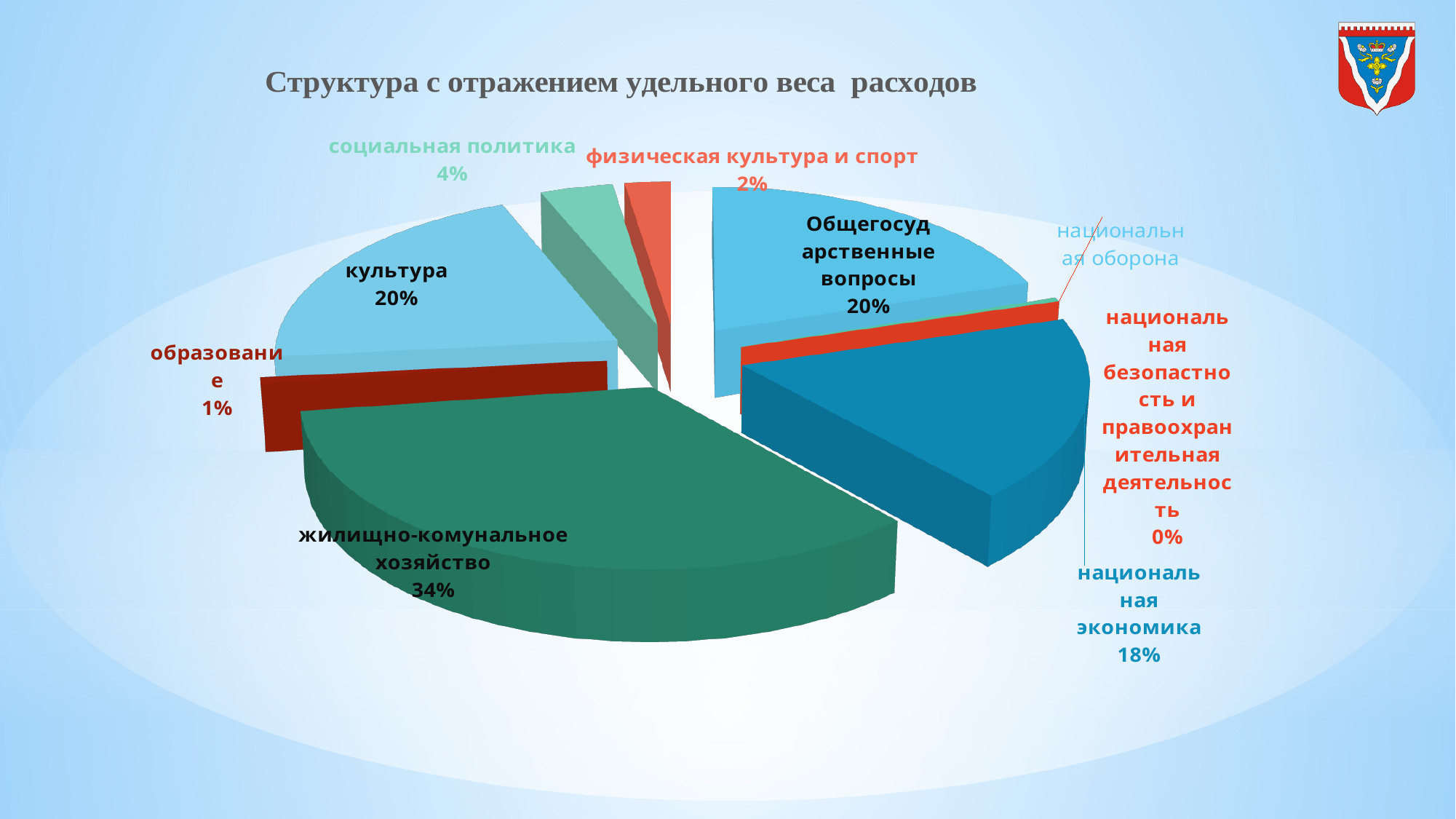
What is the title of the chart? Структура с отражением удельного веса расходов How many categories are labelled on the pie chart? 9 What percentage is shown for физическая культура и спорт? 2% What percentage is shown for социальная политика? 4% What is the difference in percentage points between жилищно-коммунальное хозяйство and национальная экономика? 16 What percentage is shown for национальная экономика? 18% What share of expenditures does жилищно-коммунальное хозяйство account for? 34% What kind of chart is shown on the slide? pie chart Which category has the largest share of the pie? жилищно-коммунальное хозяйство Which is larger, the share for культура or the share for национальная экономика? культура What percentage is shown for образование? 1% Which category is labelled with 0%? национальная безопастность и правоохранительная деятельность